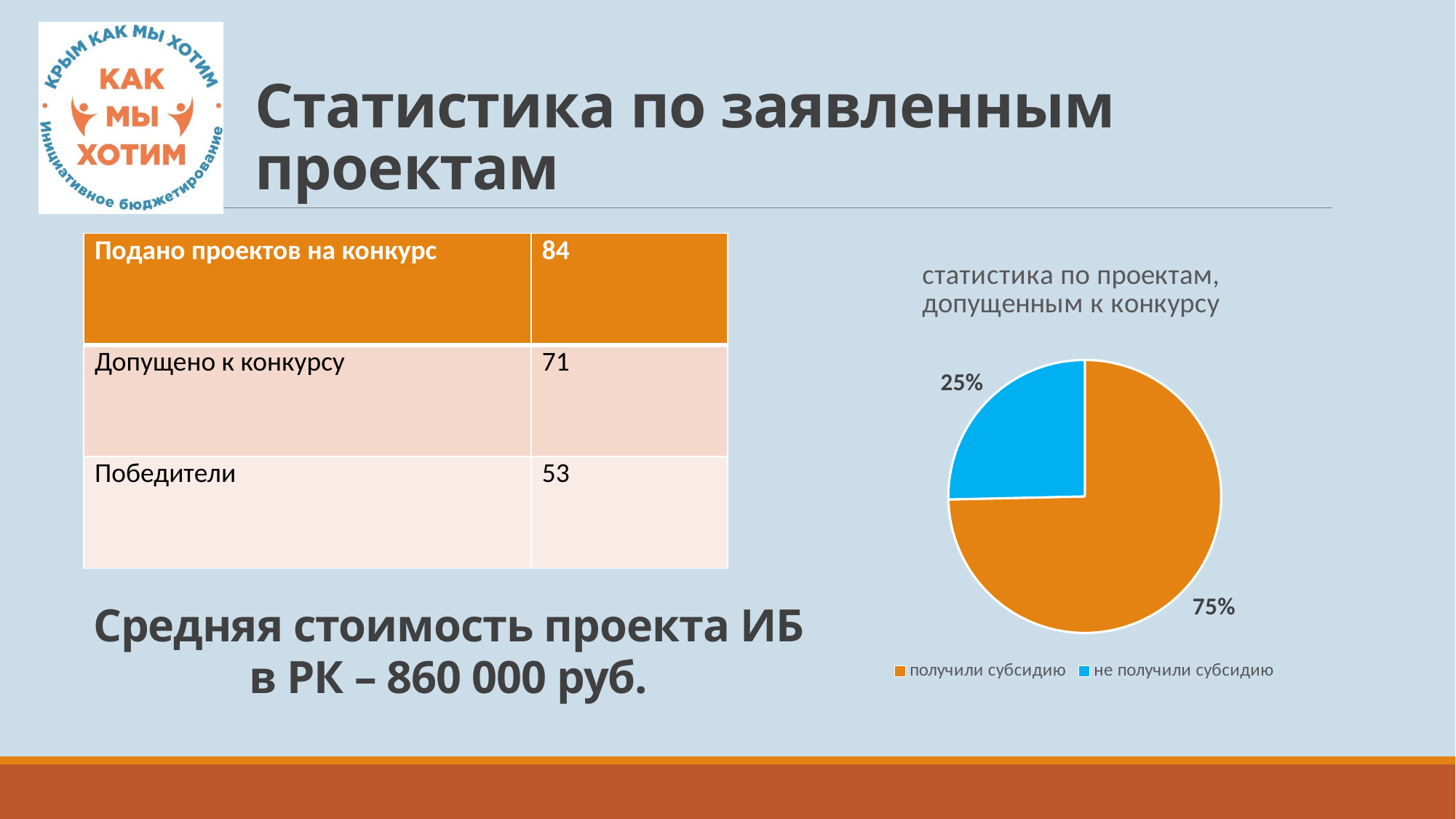
What is the title of the pie chart? статистика по проектам, допущенным к конкурсу Which is larger in the pie chart: "получили субсидию" or "не получили субсидию"? получили субсидию What kind of chart is shown on the slide? pie chart What share of the pie chart is labelled "получили субсидию"? 75% What is the difference in percentage points between the "получили субсидию" and "не получили субсидию" slices? 50 How many entries does the legend of the pie chart list? 2 Which slice of the pie chart is the largest? получили субсидию What share of the pie chart is labelled "не получили субсидию"? 25% How many slices does the pie chart have? 2 What colour is the "не получили субсидию" slice in the pie chart? blue Which slice of the pie chart is the smallest? не получили субсидию